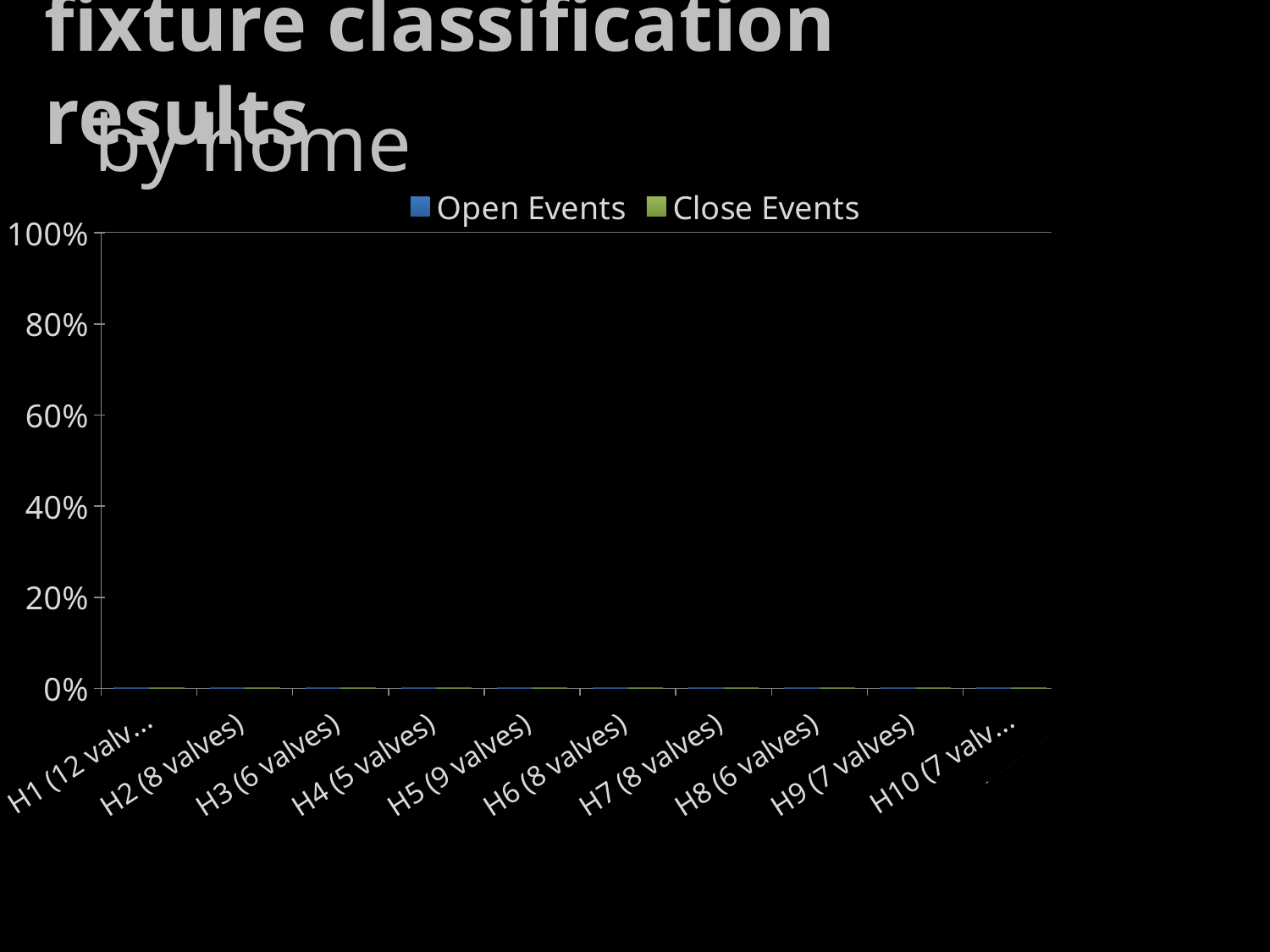
Which series in the legend is shown in blue? Open Events How many valves does the H4 category label indicate? 5 valves What are the two series named in the chart legend? Open Events and Close Events How many valves does the H5 category label indicate? 9 valves How many home categories are shown along the x axis of the chart? 10 What is the label of the last category on the x axis? H10 (7 valv... What is the highest value shown on the chart's y axis? 100% How many series does the chart legend list? 2 What is the label of the first category on the x axis? H1 (12 valv...